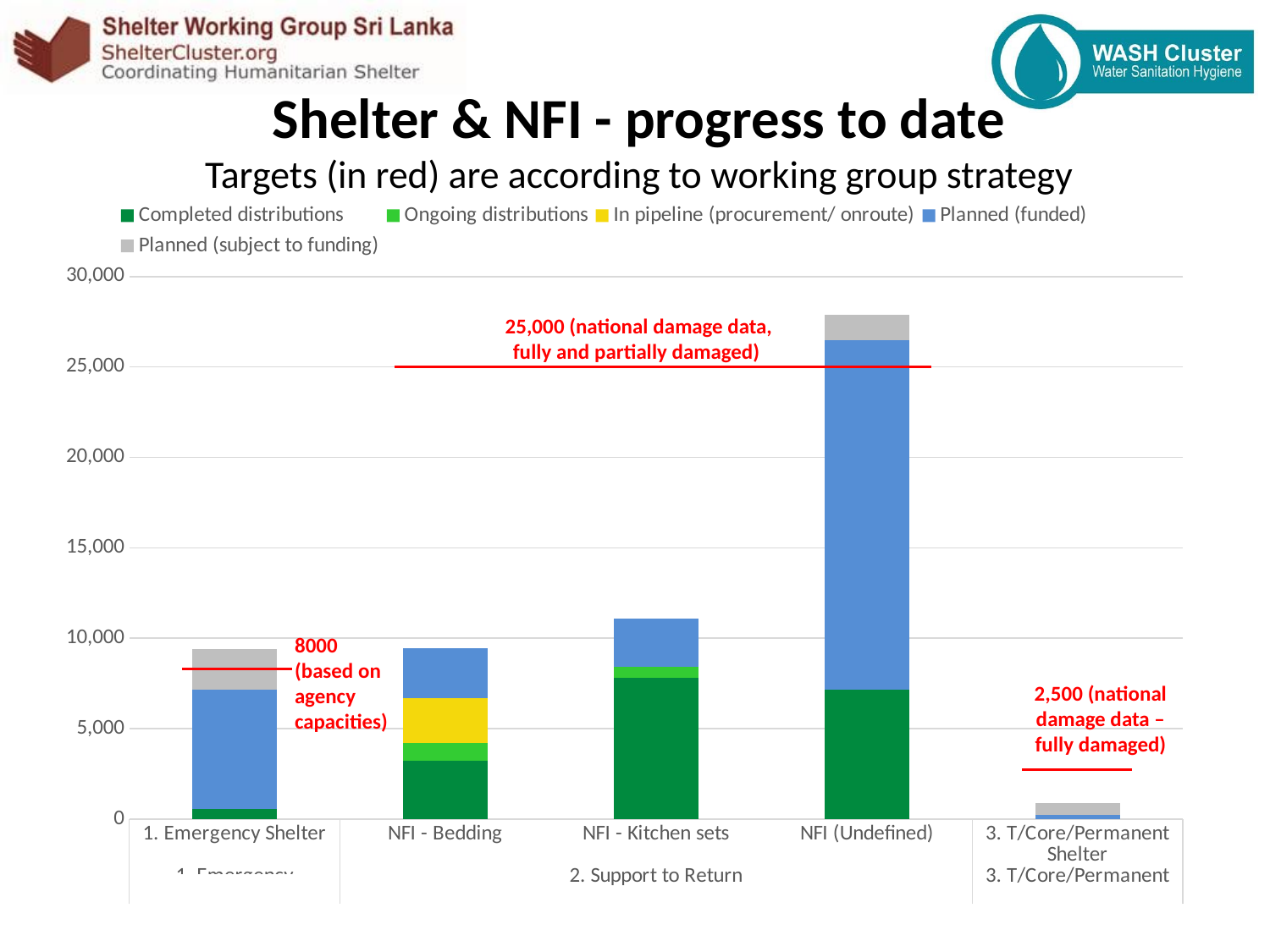
What kind of chart is shown on the slide? Stacked bar chart How many categories are shown along the x axis of the chart? 5 Which category has the shortest stacked bar? 3. T/Core/Permanent Shelter Which legend entry is shown in yellow? In pipeline (procurement/ onroute) Is the total stacked value for 3. T/Core/Permanent Shelter greater or less than 5,000? less Which has the larger total stacked bar, NFI - Kitchen sets or NFI - Bedding? NFI - Kitchen sets What target value is marked in red for NFI (Undefined)? 25,000 Is the total stacked value for NFI - Kitchen sets greater or less than 10,000? greater Which category has the tallest stacked bar? NFI (Undefined) What target value is marked in red for 1. Emergency Shelter? 8000 How many series does the chart legend list? 5 Is the total stacked value for NFI (Undefined) greater or less than 25,000? greater